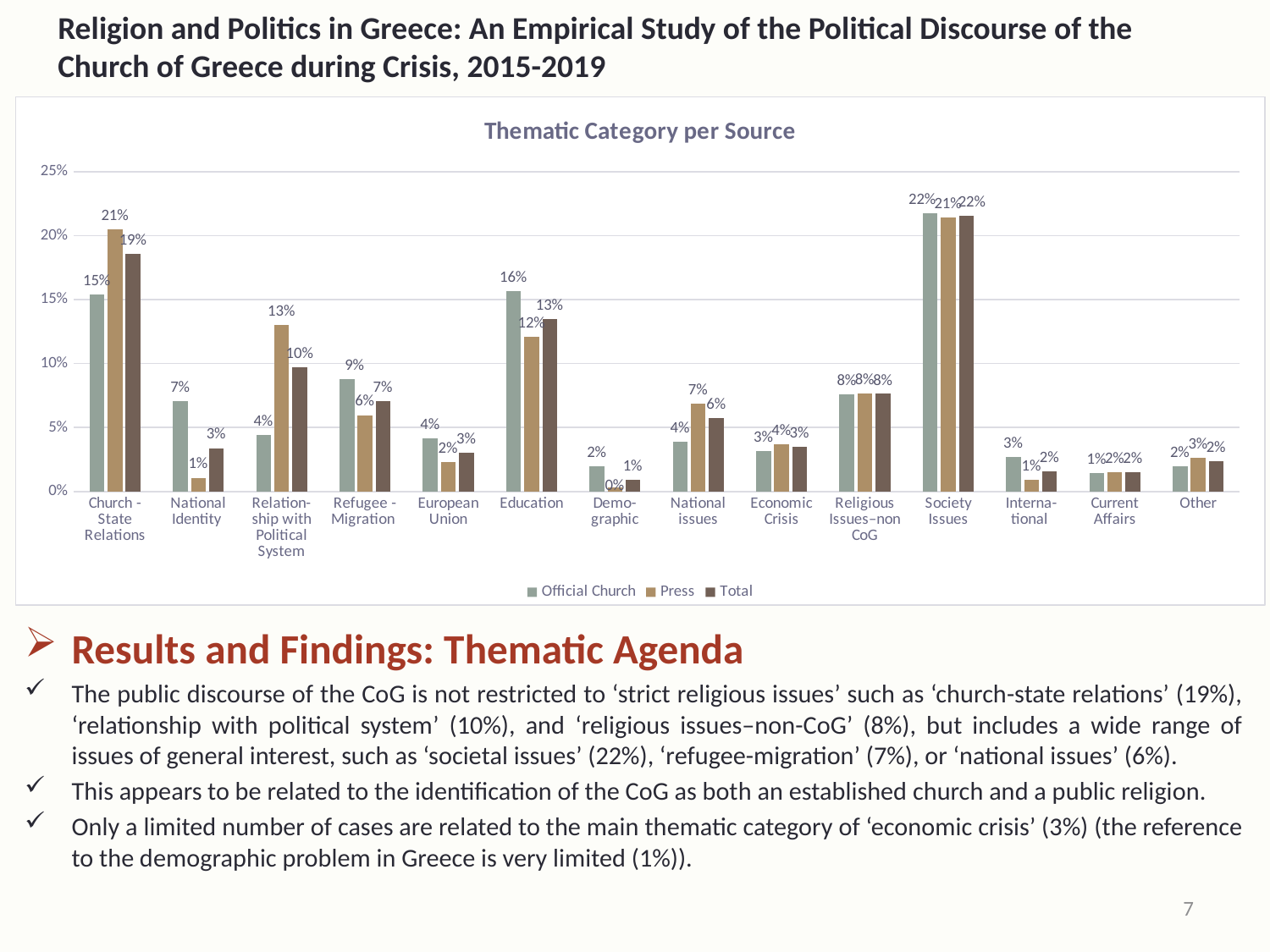
What is the Official Church value for Education? 16% Which category has the highest Official Church value? Society Issues What is the Total value for Relationship with Political System? 10% How many series does the legend list? 3 For National Identity, which is larger: the Official Church value or the Press value? Official Church What is the Press value for Church - State Relations? 21% What kind of chart is shown on the slide? Bar chart Is the Total value for Society Issues greater or less than 20%? greater What is the title of the chart? Thematic Category per Source How many thematic categories are shown on the x axis? 14 What is the difference between the Press and Official Church values for Relationship with Political System? 9% Which category has the lowest Press value? Demographic